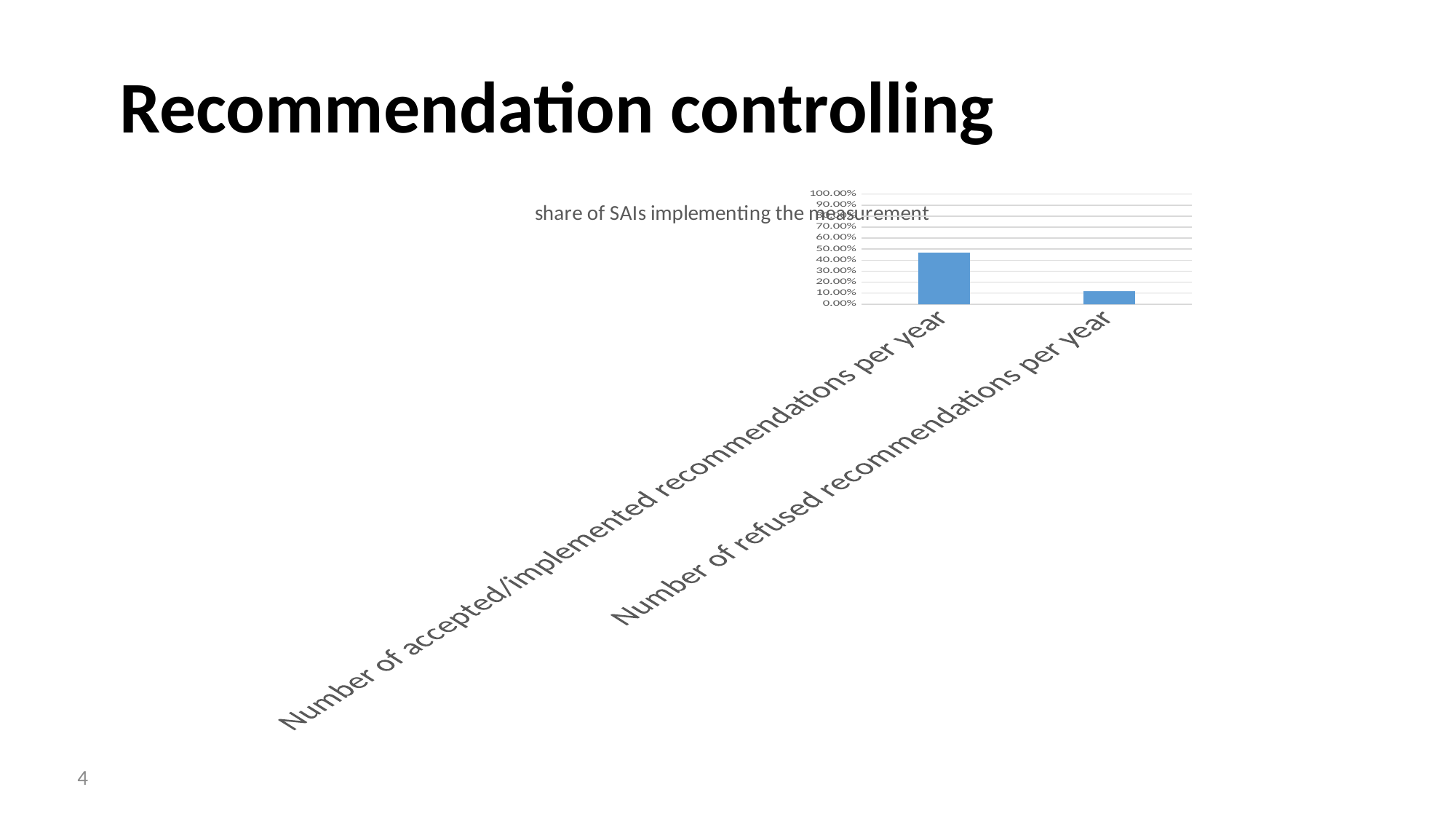
Which category has the lowest value in the chart? Number of refused recommendations per year What is the highest value shown on the vertical axis of the chart? 100.00% What is the title of the chart? share of SAIs implementing the measurement Which category has the highest value in the chart? Number of accepted/implemented recommendations per year Which is larger: the value for 'Number of accepted/implemented recommendations per year' or the value for 'Number of refused recommendations per year'? Number of accepted/implemented recommendations per year Is the value for 'Number of accepted/implemented recommendations per year' greater or less than 60.00%? less What kind of chart is shown on the slide? bar chart Is the value for 'Number of refused recommendations per year' greater or less than 50.00%? less How many categories are plotted in the chart? 2 Is the value for 'Number of refused recommendations per year' greater or less than 20.00%? less Do the values rise or fall from the first category to the second category along the x axis? fall